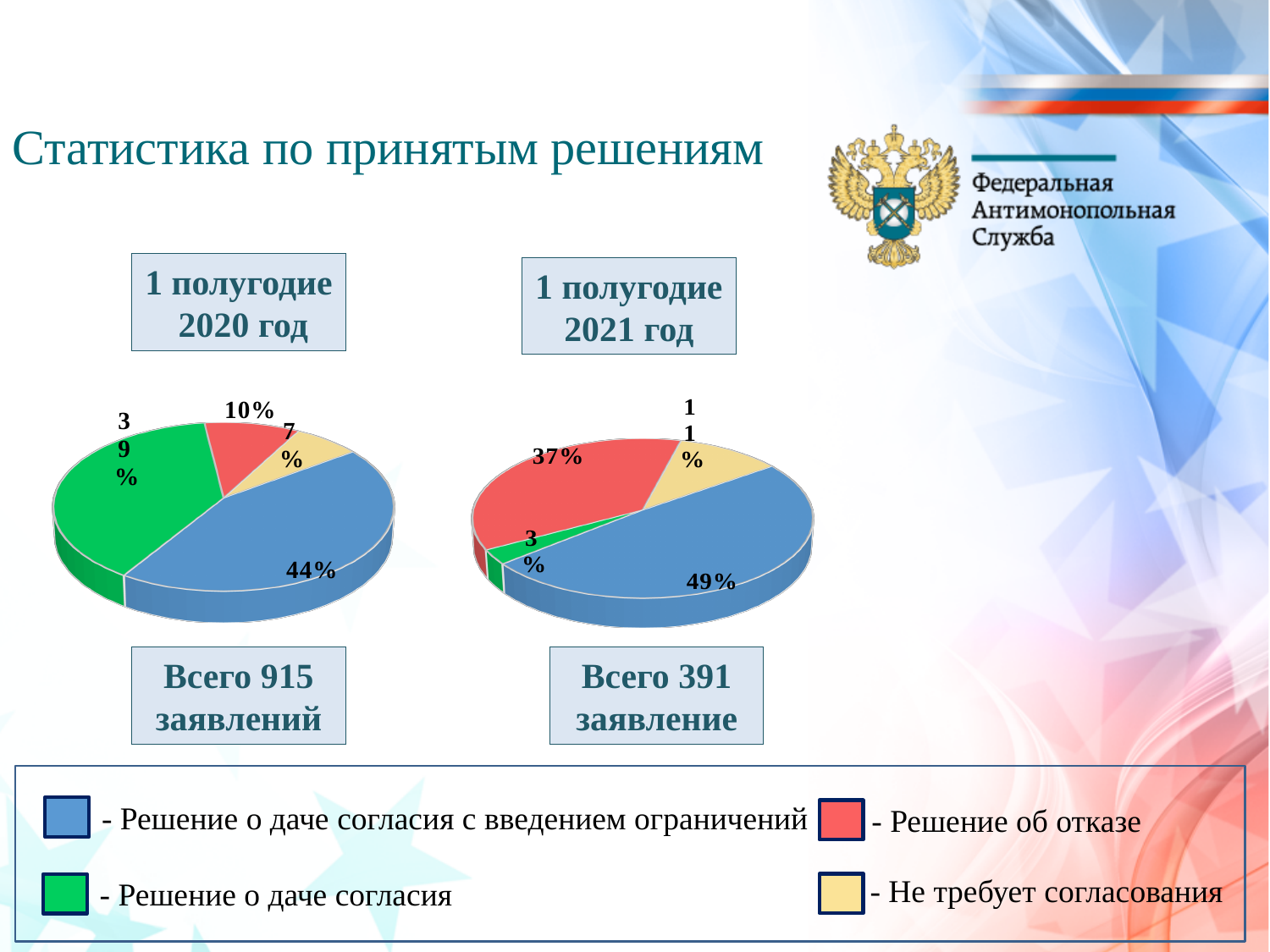
На диаграмме «1 полугодие 2021 год» какая категория имеет наименьшую долю? Решение о даче согласия На диаграмме «1 полугодие 2020 год» какая категория имеет наименьшую долю? Не требует согласования На диаграмме «1 полугодие 2021 год» какая доля приходится на «Решение об отказе»? 37% На диаграмме «1 полугодие 2021 год» какая доля приходится на «Не требует согласования»? 11% Какого типа диаграммы показаны на слайде? Круговые диаграммы На диаграмме «1 полугодие 2021 год» что больше: доля «Решение об отказе» или доля «Решение о даче согласия»? Решение об отказе На диаграмме «1 полугодие 2020 год» на сколько процентных пунктов доля «Решение о даче согласия с введением ограничений» больше доли «Решение об отказе»? 34 Сколько всего заявлений указано под диаграммой «1 полугодие 2021 год»? 391 На диаграмме «1 полугодие 2021 год» какая категория имеет наибольшую долю? Решение о даче согласия с введением ограничений На диаграмме «1 полугодие 2020 год» какая доля приходится на «Решение о даче согласия»? 39% Сколько категорий показано на диаграмме «1 полугодие 2020 год»? 4 На диаграмме «1 полугодие 2020 год» какая доля приходится на «Решение о даче согласия с введением ограничений»? 44%